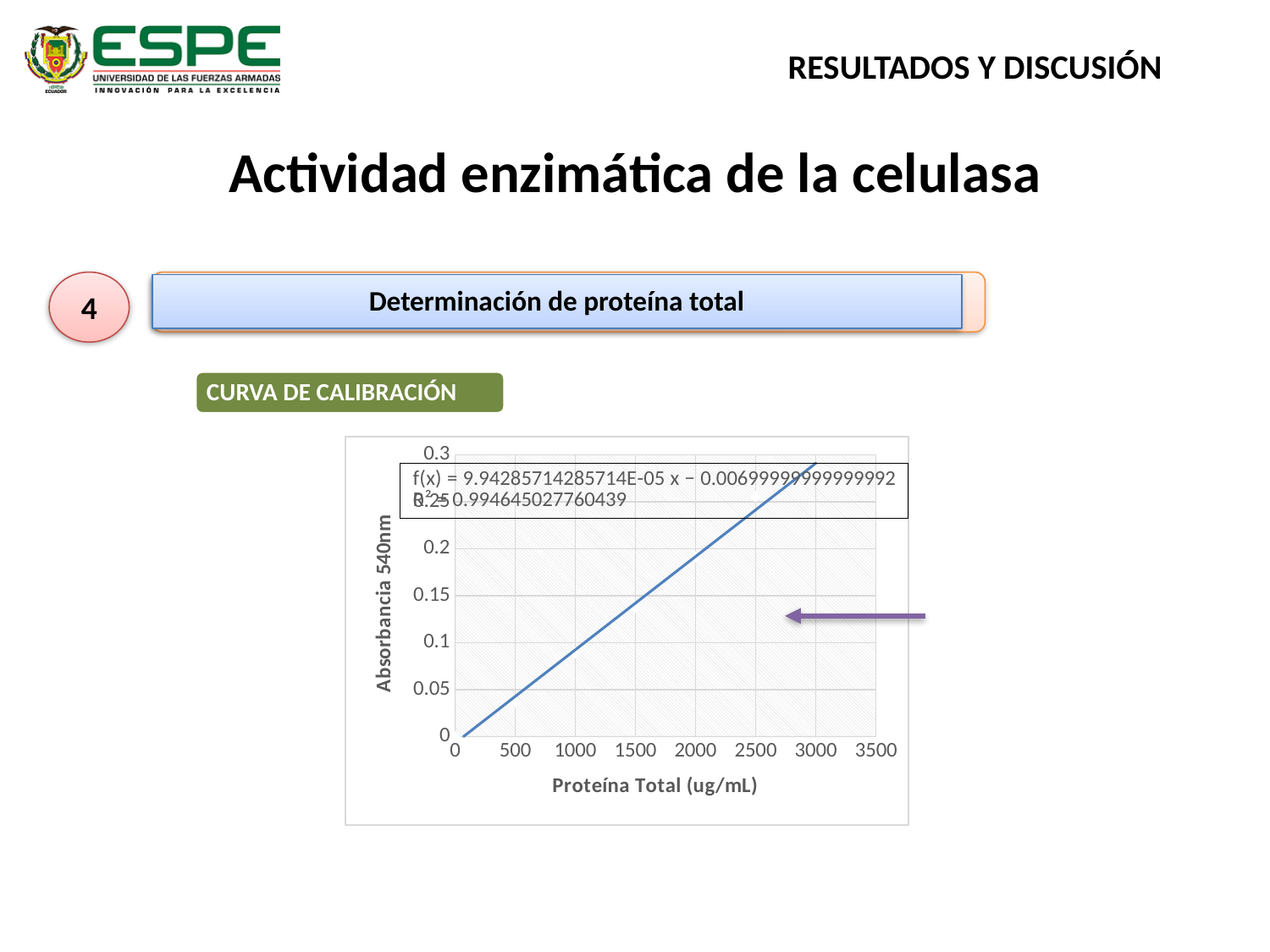
Which has the higher absorbance on the calibration curve, 1000 ug/mL or 3000 ug/mL of Proteína Total? 3000 ug/mL Is the absorbance value at 2000 ug/mL of Proteína Total greater or less than 0.15? greater What is the highest value shown on the y axis of the calibration curve? 0.3 Is the absorbance value at 500 ug/mL of Proteína Total greater or less than 0.1? less Is the absorbance value at 2500 ug/mL of Proteína Total greater or less than 0.2? greater Does the absorbance rise or fall as Proteína Total increases along the x axis? rise What kind of chart is shown under 'CURVA DE CALIBRACIÓN'? line chart What is the R² value shown on the calibration curve chart? 0.994645027760439